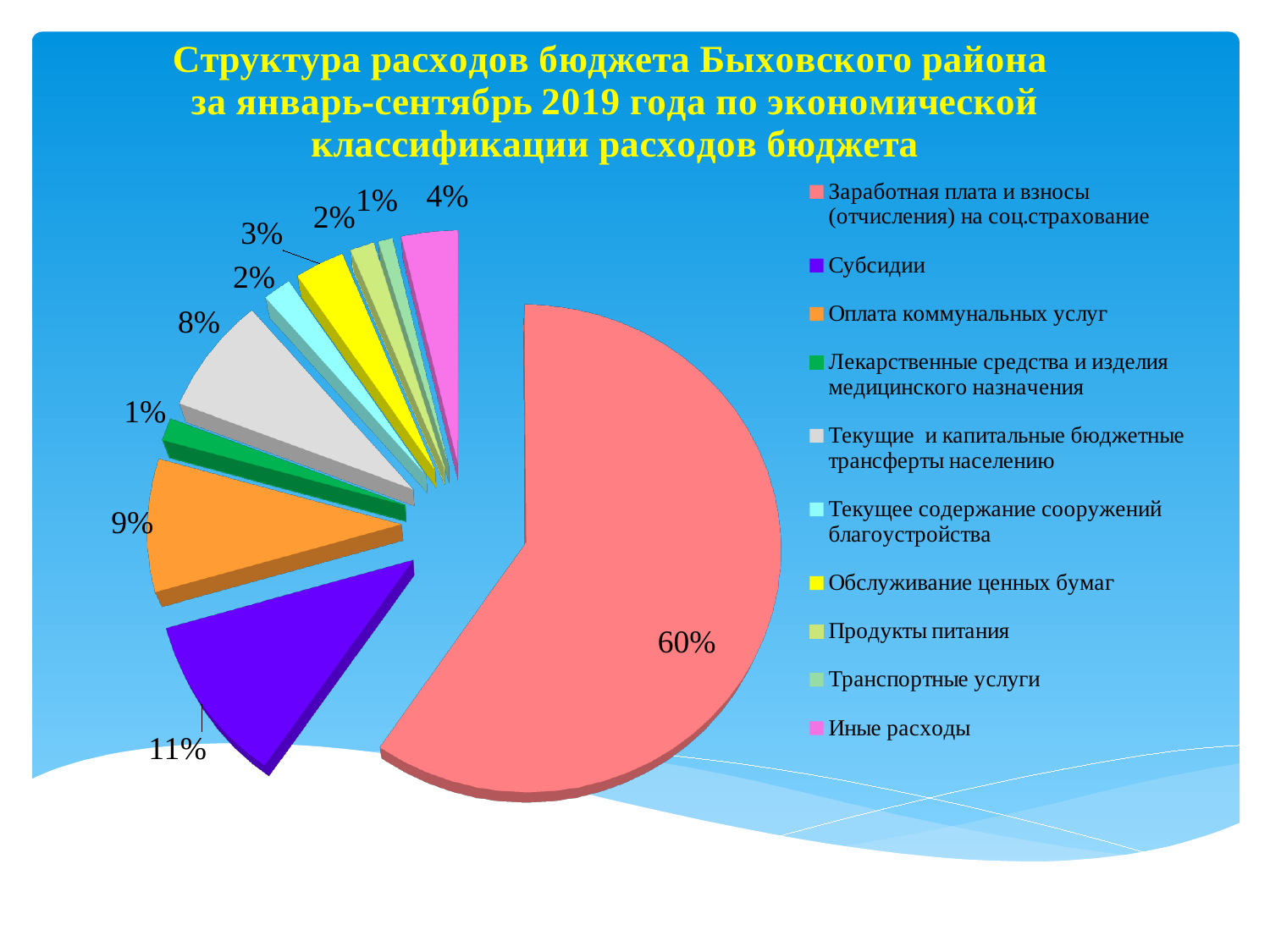
What share of expenditures is for Субсидии? 11% Which category has the largest share of the pie? Заработная плата и взносы (отчисления) на соц.страхование What kind of chart is shown on the slide? pie chart What share of expenditures is for Иные расходы? 4% How many entries does the legend list? 10 What share of expenditures is for Текущие и капитальные бюджетные трансферты населению? 8% Which is larger: the share for Текущие и капитальные бюджетные трансферты населению or the share for Иные расходы? Текущие и капитальные бюджетные трансферты населению What share of expenditures is for Оплата коммунальных услуг? 9% What colour is the slice for Субсидии? purple What is the difference in percentage points between Субсидии and Оплата коммунальных услуг? 2 What share of expenditures is for Обслуживание ценных бумаг? 3% What share of expenditures is for Заработная плата и взносы (отчисления) на соц.страхование? 60%